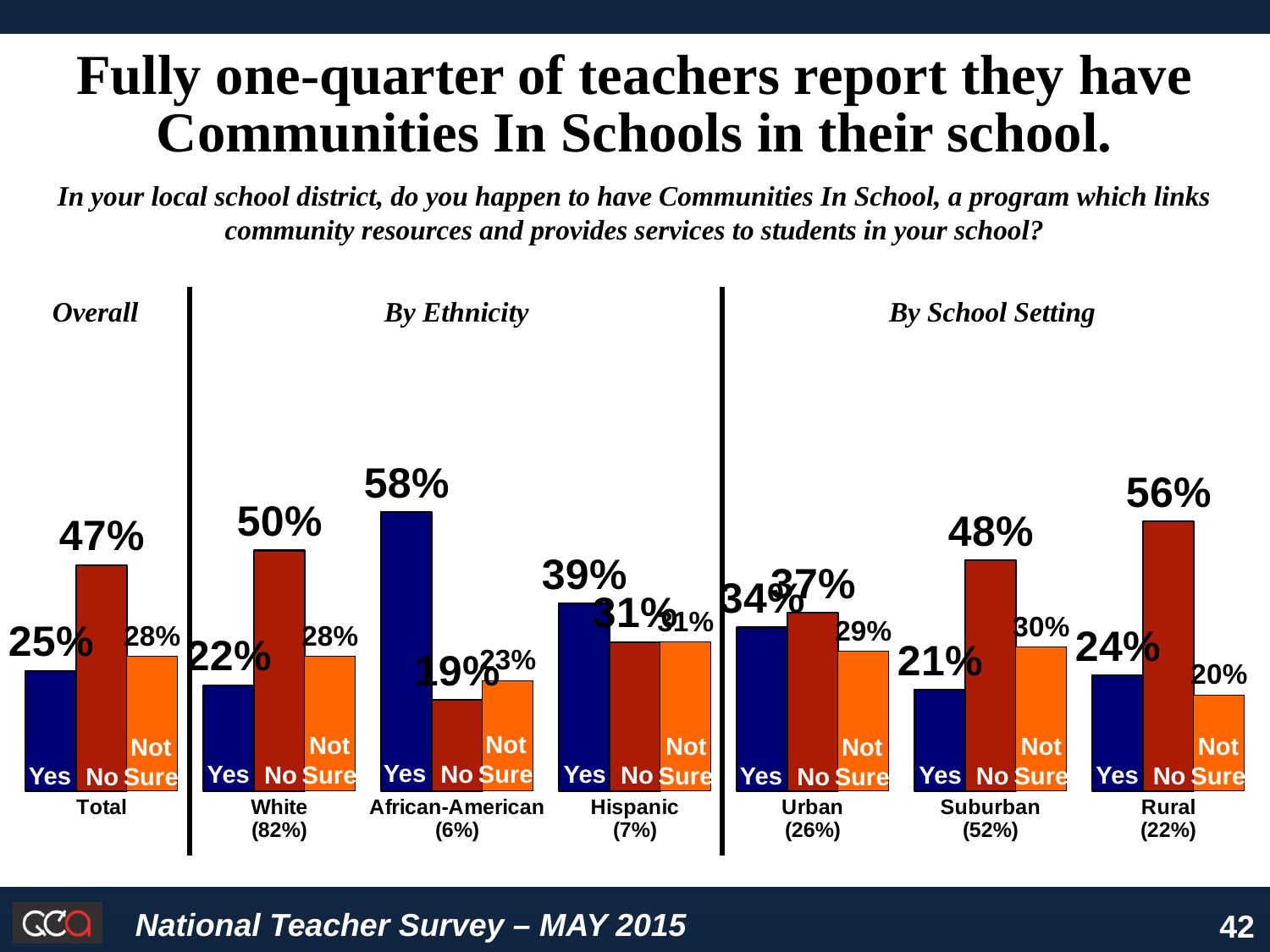
What percentage of teachers overall (Total) answered No? 47% What kind of chart is shown on the slide? Bar chart What is the Yes value for African-American teachers? 58% Which group has the highest Yes value? African-American What is the Not Sure value for Suburban teachers? 30% How many groups (categories) are shown along the x axis? 7 What is the difference between the No value and the Yes value for White teachers? 28% What is the No value for Rural teachers? 56% What percentage of teachers overall (Total) answered Yes? 25% What share of the sample is Suburban, as shown in the x-axis label? 52% Which group has the lowest Yes value? Suburban Which is larger for Urban teachers, the Yes value or the No value? No